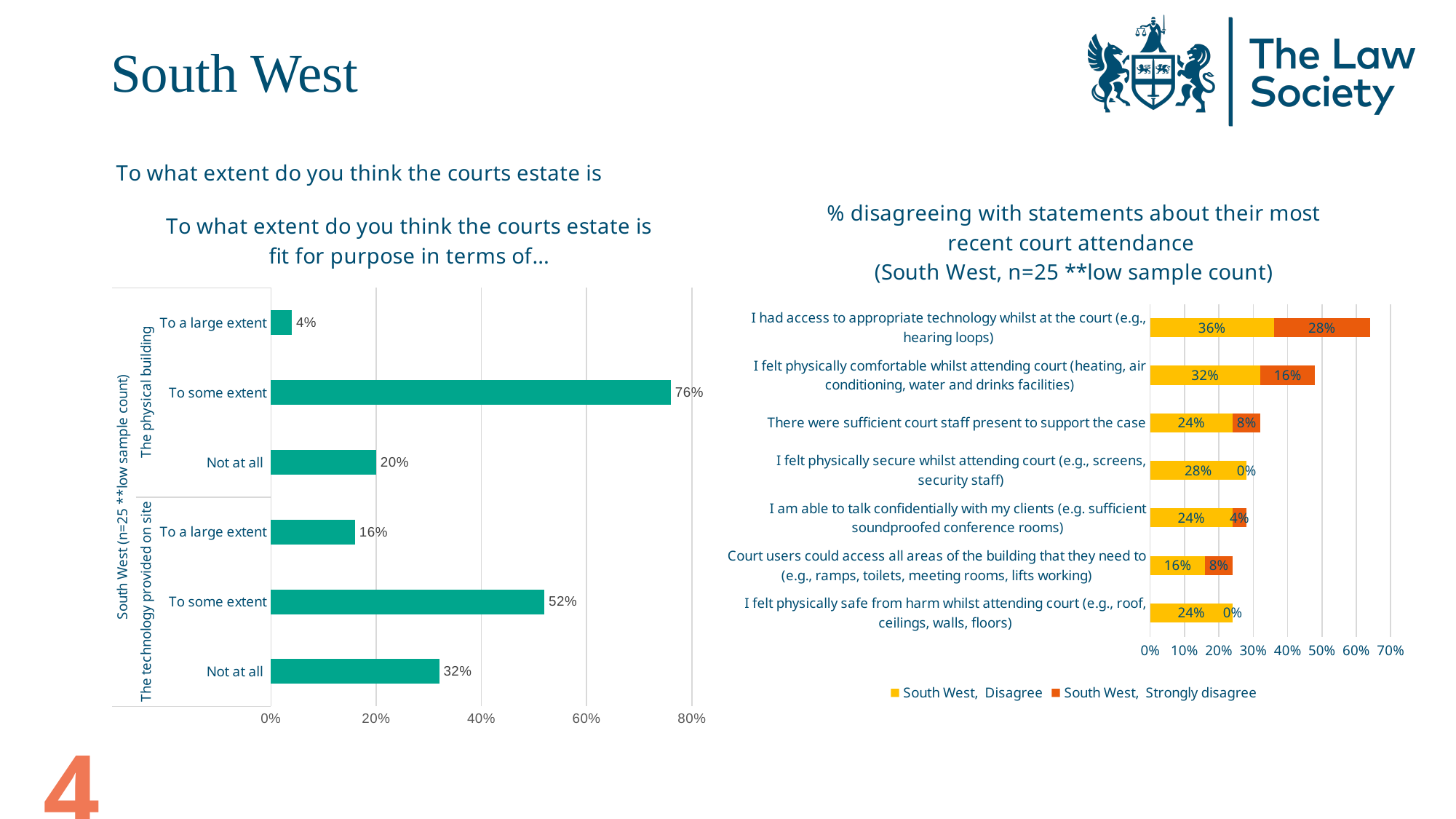
In the right chart, what is the total of the stacked bar for 'I had access to appropriate technology whilst at the court'? 64% In the left chart, what is the difference between 'To some extent' for the physical building and 'To some extent' for the technology provided on site? 24% In the right chart, which statement has the highest 'Disagree' value? I had access to appropriate technology whilst at the court (e.g., hearing loops) In the left chart, which category under 'The physical building' has the lowest value? To a large extent In the left chart, what is the value for 'Not at all' under 'The technology provided on site'? 32% What type of chart is the left chart? Bar chart In the right chart '% disagreeing with statements about their most recent court attendance', what is the 'Strongly disagree' value for 'I had access to appropriate technology whilst at the court'? 28% In the right chart, how many series does the legend list? 2 In the right chart, how many statements are plotted? 7 In the left chart, which is larger: 'To a large extent' for the physical building or 'To a large extent' for the technology provided on site? The technology provided on site In the left chart 'To what extent do you think the courts estate is fit for purpose in terms of...', what is the value for 'To some extent' under 'The physical building'? 76% In the right chart, what is the 'Disagree' value for 'I felt physically comfortable whilst attending court'? 32%